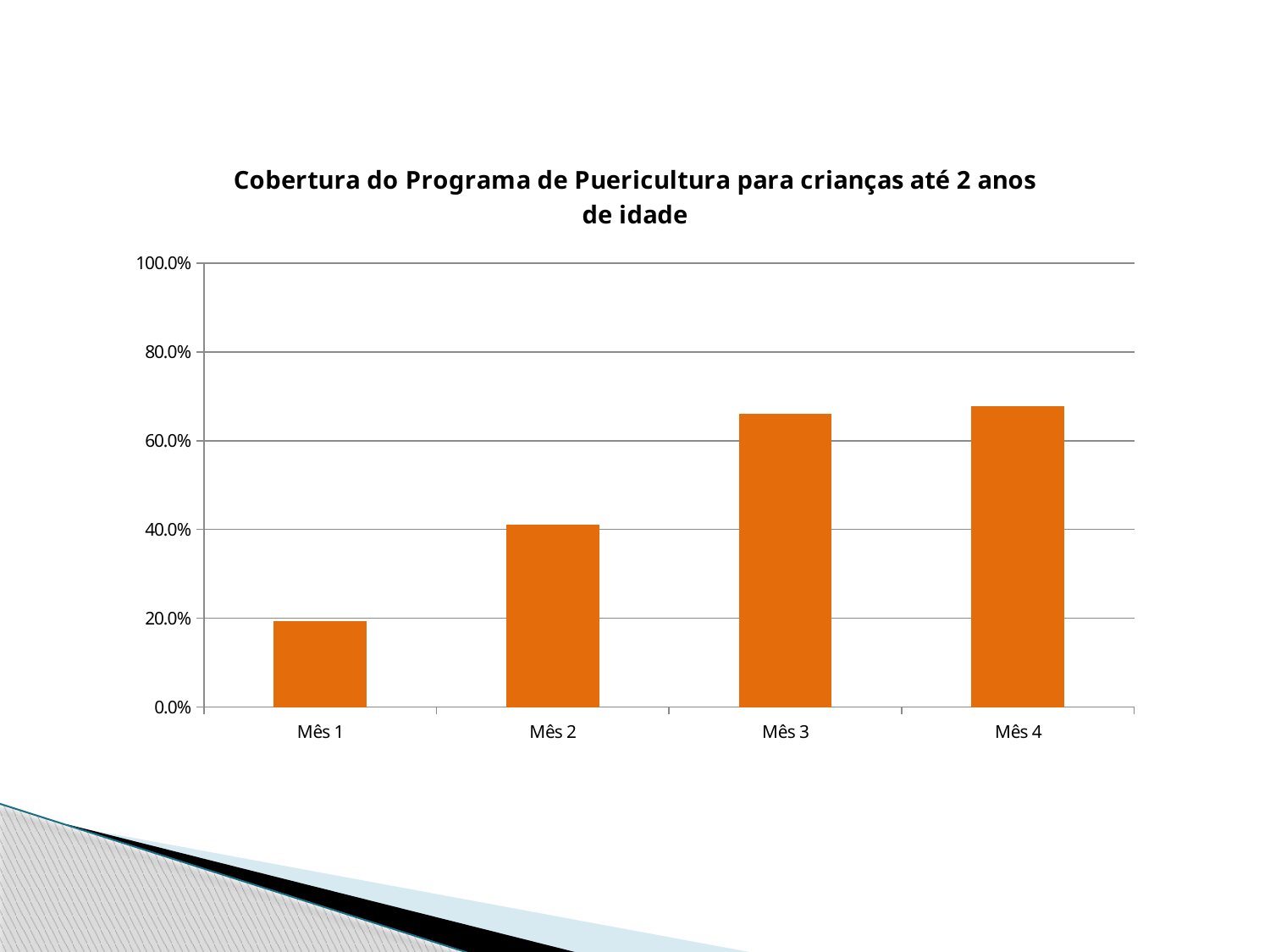
How many months (categories) are plotted on the chart? 4 Is the value for Mês 3 greater or less than 60.0%? greater Do the coverage values rise or fall from Mês 1 to Mês 4? rise Which month has the lowest coverage value? Mês 1 Is the value for Mês 4 greater or less than 80.0%? less Which is larger, the value for Mês 1 or the value for Mês 3? Mês 3 What is the title of the chart? Cobertura do Programa de Puericultura para crianças até 2 anos de idade Is the value for Mês 2 greater or less than 60.0%? less What kind of chart is shown on the slide? bar chart Which is larger, the value for Mês 2 or the value for Mês 4? Mês 4